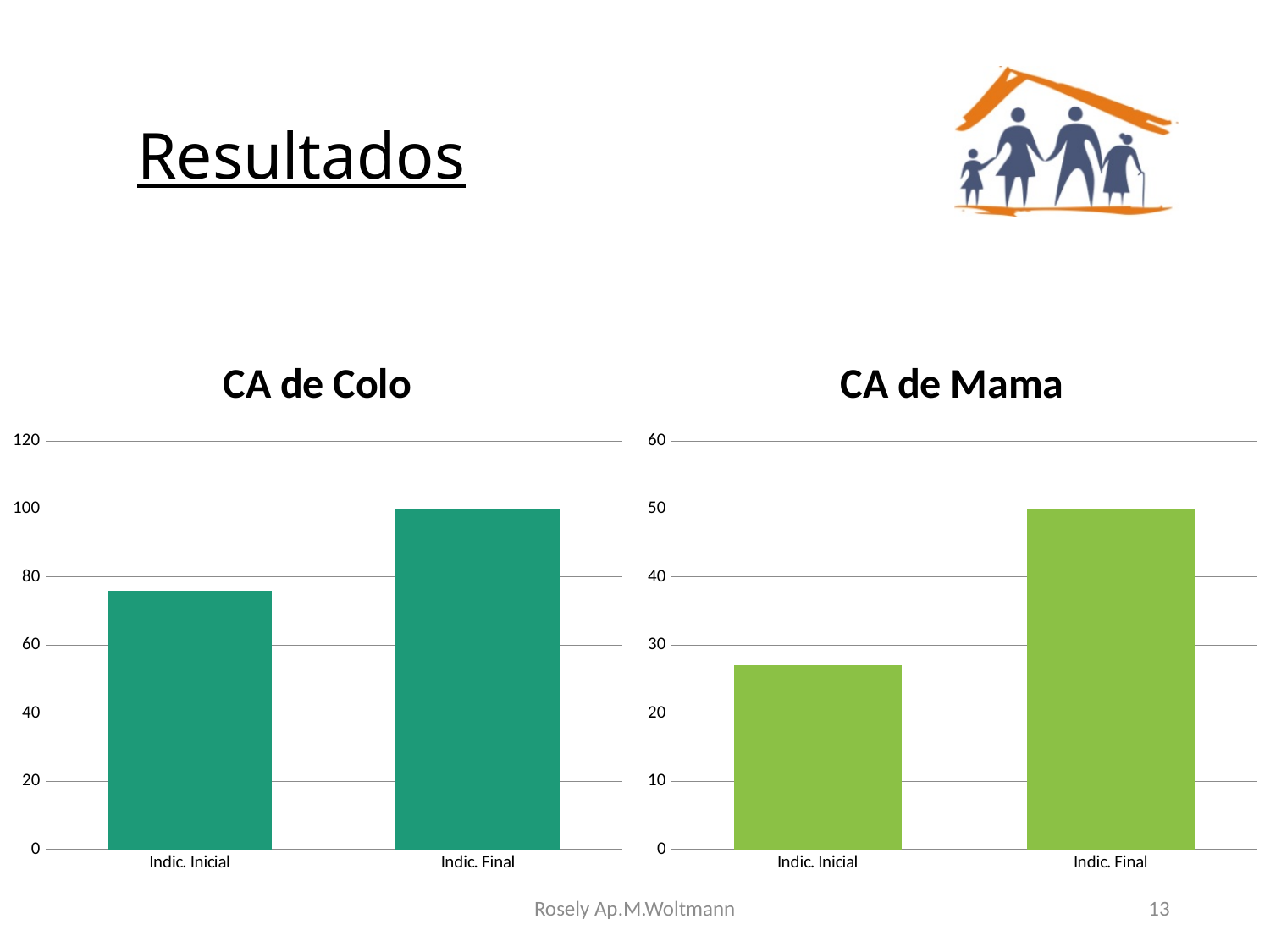
In the CA de Mama chart, what is the value for Indic. Final? 50 In the CA de Mama chart, which is larger, Indic. Inicial or Indic. Final? Indic. Final In the CA de Mama chart, which category has the lowest value? Indic. Inicial In the CA de Colo chart, which category has the highest value? Indic. Final How many categories are shown in the CA de Colo chart? 2 In the CA de Colo chart, what is the value for Indic. Final? 100 In the CA de Mama chart, is the value for Indic. Inicial greater or less than 30? less In the CA de Colo chart, is the value for Indic. Inicial greater or less than 60? greater In the CA de Colo chart, is the value for Indic. Inicial greater or less than 80? less What kind of chart is the CA de Mama chart? bar chart What is the title of the chart on the left side of the slide? CA de Colo